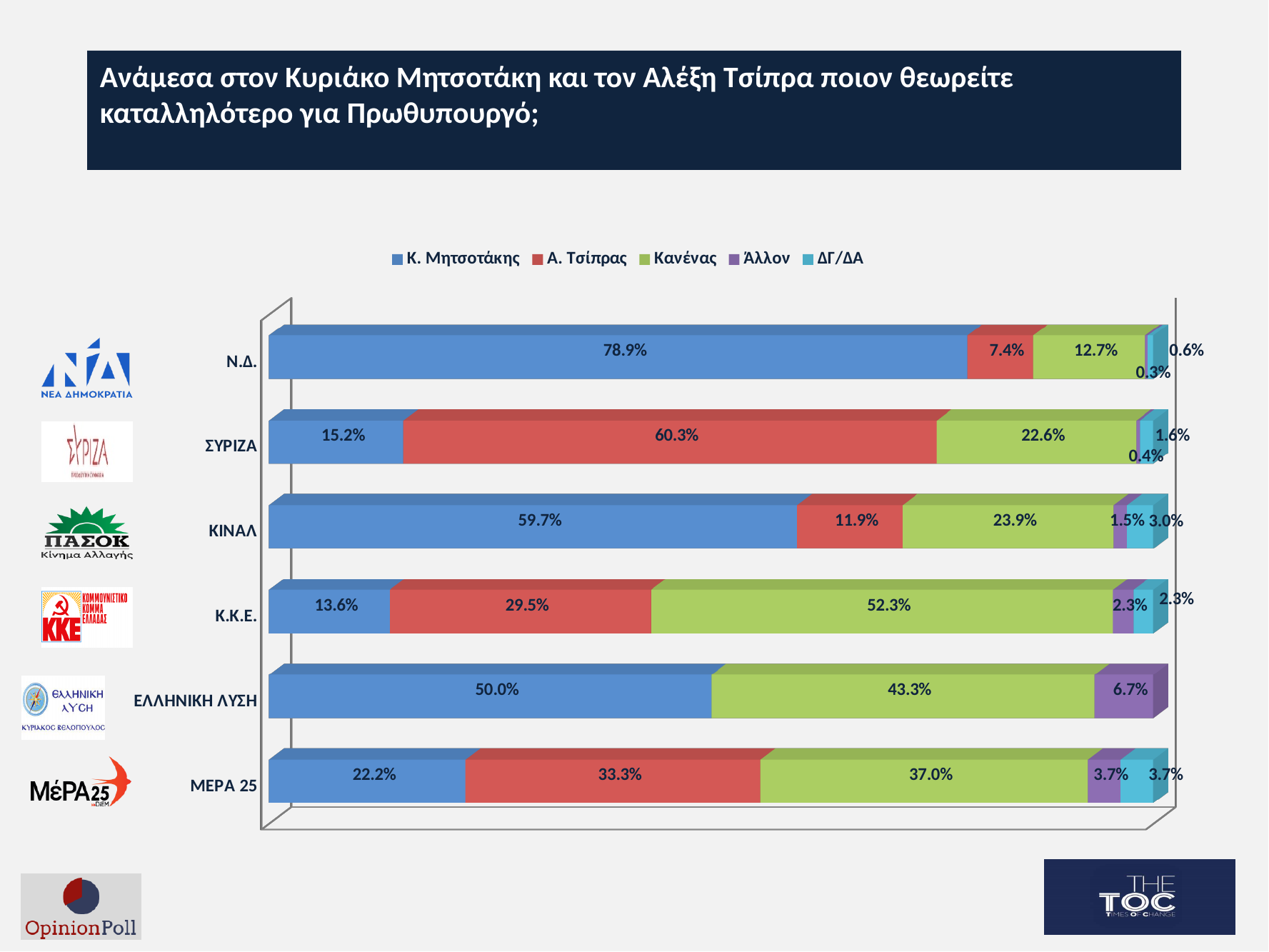
What is the value for Κ. Μητσοτάκης among Ν.Δ. voters? 78.9% What is the value for Άλλον among ΕΛΛΗΝΙΚΗ ΛΥΣΗ voters? 6.7% What type of chart is shown on the slide? stacked bar chart Which series is shown in green in the legend? Κανένας Which party category has the highest value for Κ. Μητσοτάκης? Ν.Δ. How many series does the legend list? 5 What is the difference between the Κ. Μητσοτάκης value for ΚΙΝΑΛ and the Α. Τσίπρας value for ΚΙΝΑΛ? 47.8% Which party category has the lowest value for Κ. Μητσοτάκης? Κ.Κ.Ε. What is the value for Κανένας among Κ.Κ.Ε. voters? 52.3% What is the value for Α. Τσίπρας among ΣΥΡΙΖΑ voters? 60.3% Among ΜΕΡΑ 25 voters, which is larger: the value for Α. Τσίπρας or the value for Κανένας? Κανένας How many party categories are plotted on the chart? 6